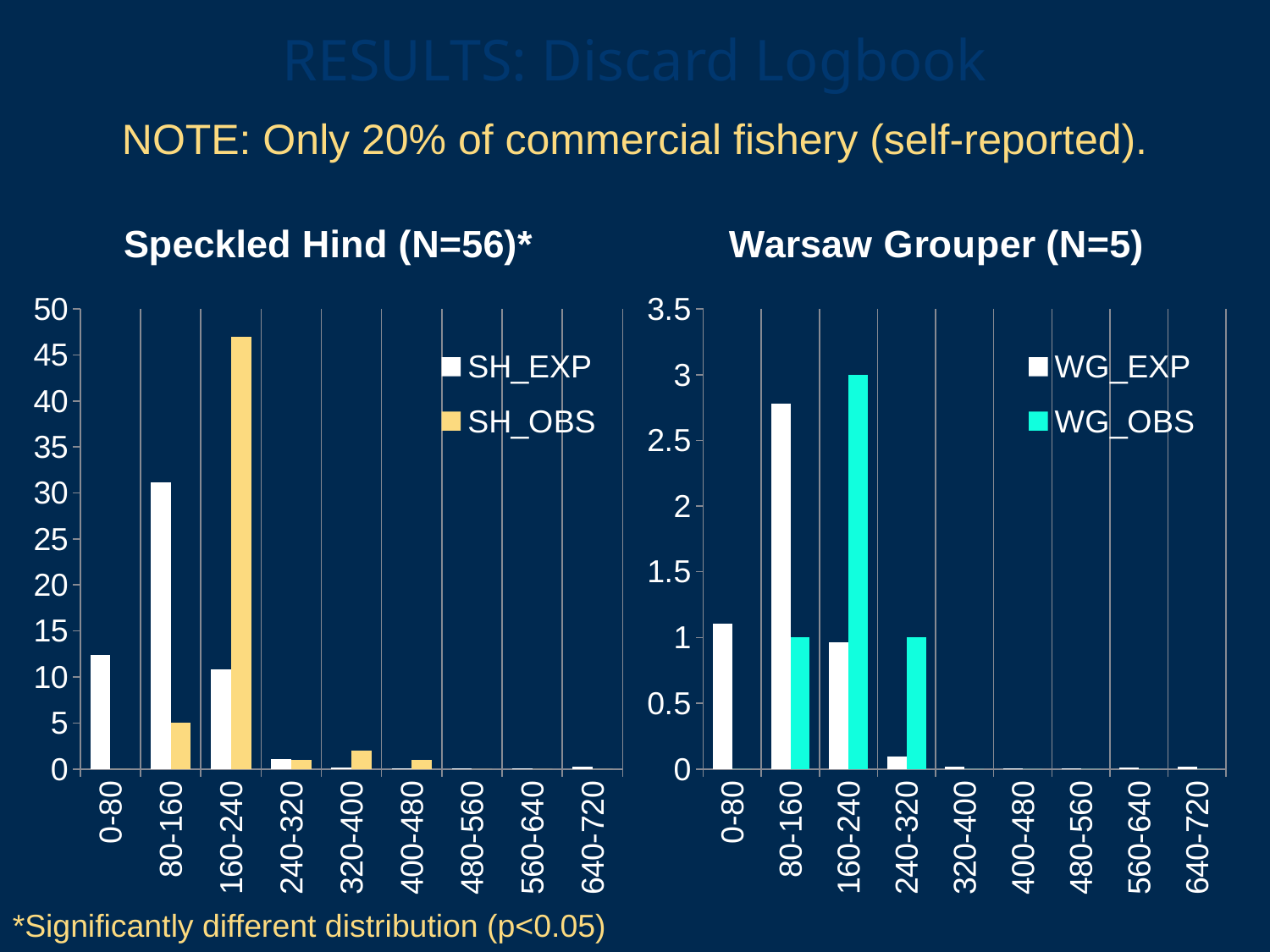
What kind of chart is the Speckled Hind (N=56)* chart? bar chart In the Speckled Hind (N=56)* chart, which category has the highest SH_EXP value? 80-160 What are the two legend entries in the Speckled Hind (N=56)* chart? SH_EXP and SH_OBS How many series does the legend of the Warsaw Grouper (N=5) chart list? 2 In the Speckled Hind (N=56)* chart, which is larger for 0-80: SH_EXP or SH_OBS? SH_EXP In the Speckled Hind (N=56)* chart, is the SH_OBS value for 160-240 greater or less than 45? greater How many categories are shown on the x axis of the Speckled Hind (N=56)* chart? 9 In the Warsaw Grouper (N=5) chart, which category has the highest WG_OBS value? 160-240 In the Warsaw Grouper (N=5) chart, what is the WG_OBS value for 160-240? 3 In the Speckled Hind (N=56)* chart, which category has the highest SH_OBS value? 160-240 In the Warsaw Grouper (N=5) chart, is the WG_EXP value for 80-160 greater or less than 2.5? greater In the Speckled Hind (N=56)* chart, is the SH_EXP value for 80-160 greater or less than 30? greater